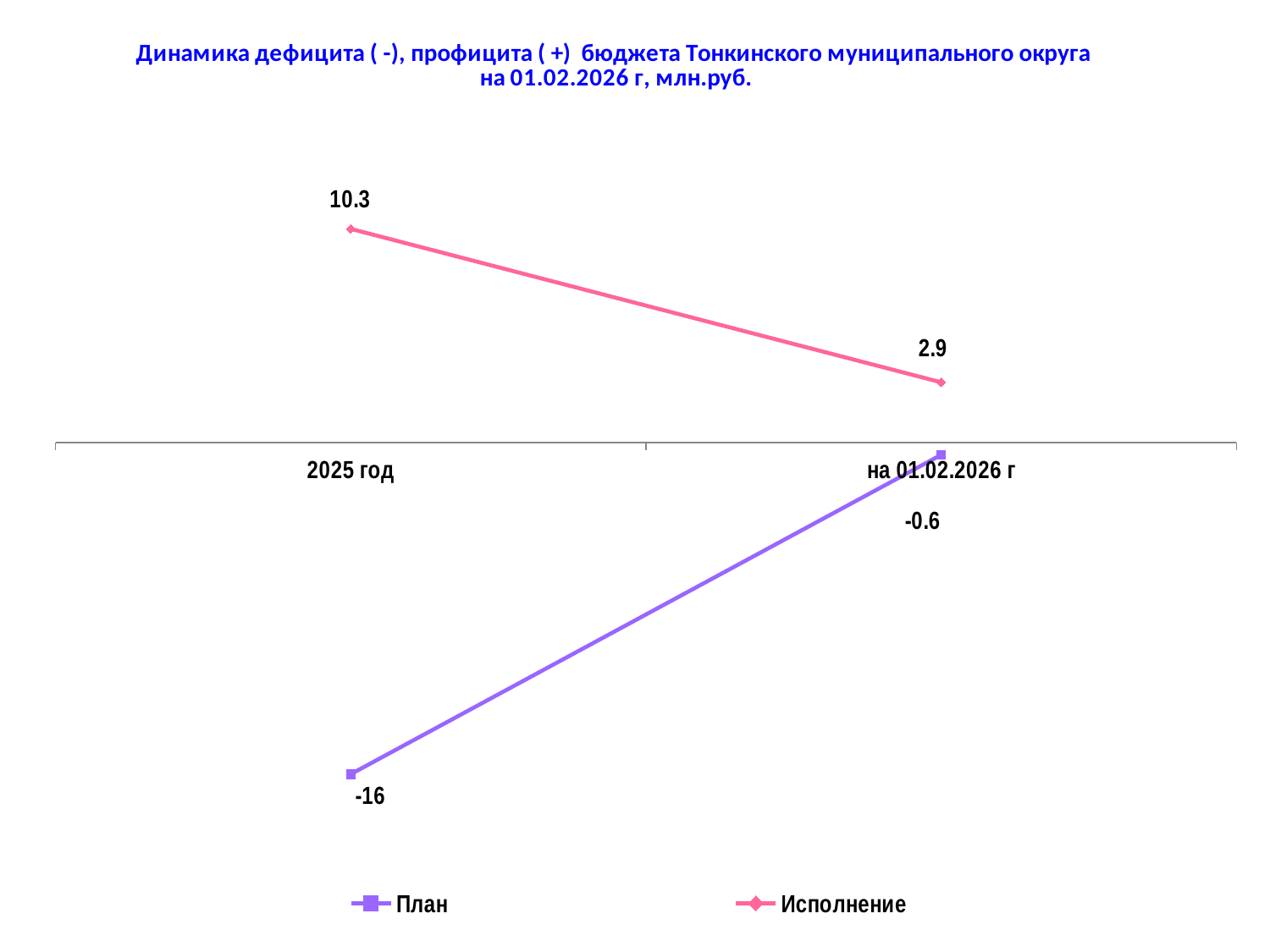
What is the value of the Исполнение series for на 01.02.2026 г? 2.9 How many series does the legend list? 2 What is the value of the Исполнение series for 2025 год? 10.3 What is the value of the План series for на 01.02.2026 г? -0.6 What is the difference between the Исполнение and План values for 2025 год? 26.3 Which category has the highest value for the Исполнение series? 2025 год Which is larger for на 01.02.2026 г: the План value or the Исполнение value? Исполнение Does the План series rise or fall from 2025 год to на 01.02.2026 г? Rise What is the value of the План series for 2025 год? -16 What is the difference between the Исполнение values for 2025 год and на 01.02.2026 г? 7.4 Which category has the lowest value for the План series? 2025 год What kind of chart is shown on the slide? Line chart